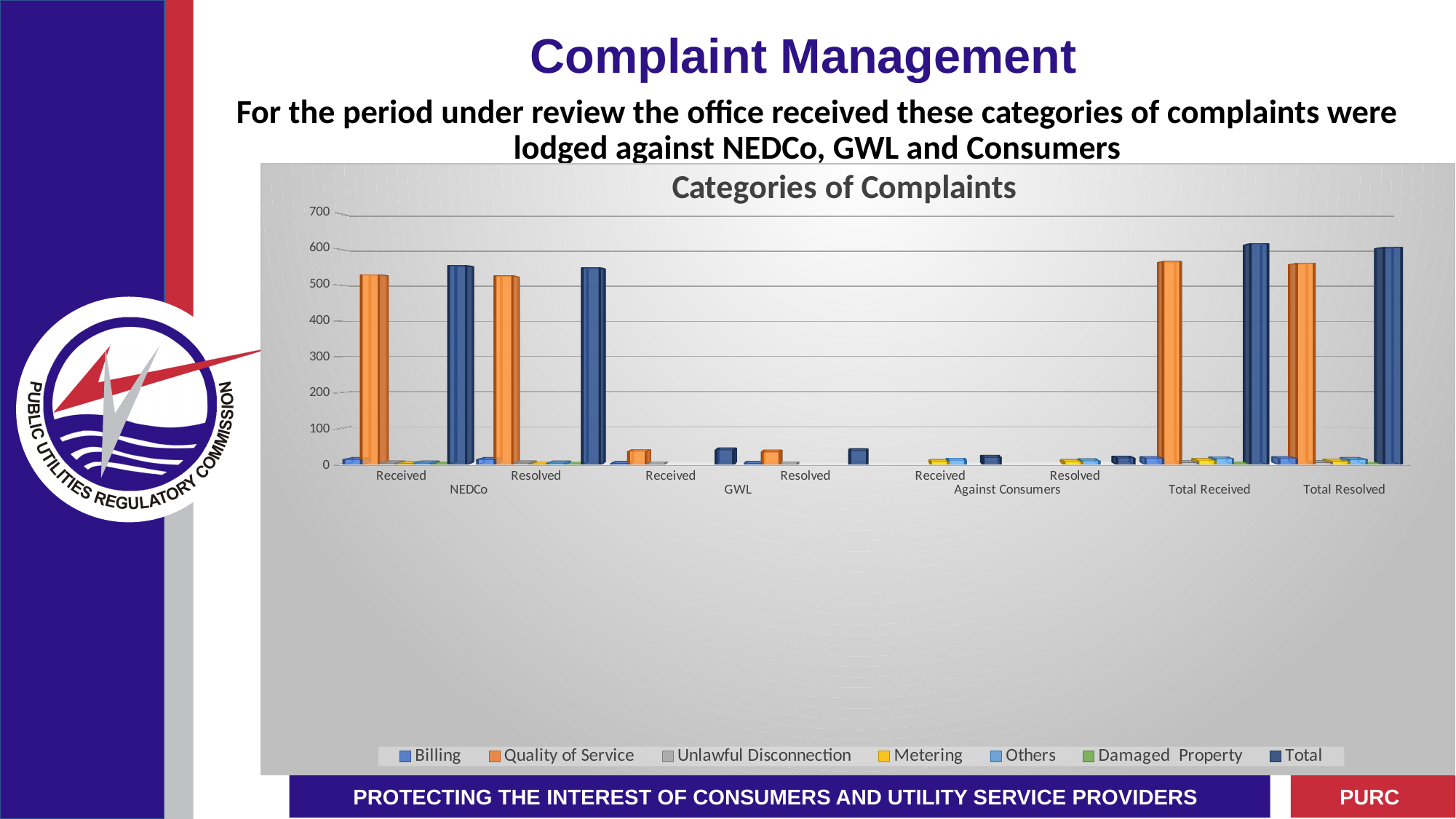
What kind of chart is shown on the slide? bar chart Which colour represents the Quality of Service series in the chart? orange Which is larger: the Quality of Service value for NEDCo Received or for GWL Received? NEDCo Received Which series has the highest bar in the NEDCo Received group? Total Is the Total value for GWL Received greater or less than 100? less How many category groups are shown along the x axis of the chart? 8 Is the Quality of Service value for Total Received greater or less than 600? less What is the title of the chart? Categories of Complaints How many series does the chart legend list? 7 Is the Quality of Service value for NEDCo Received greater or less than 500? greater